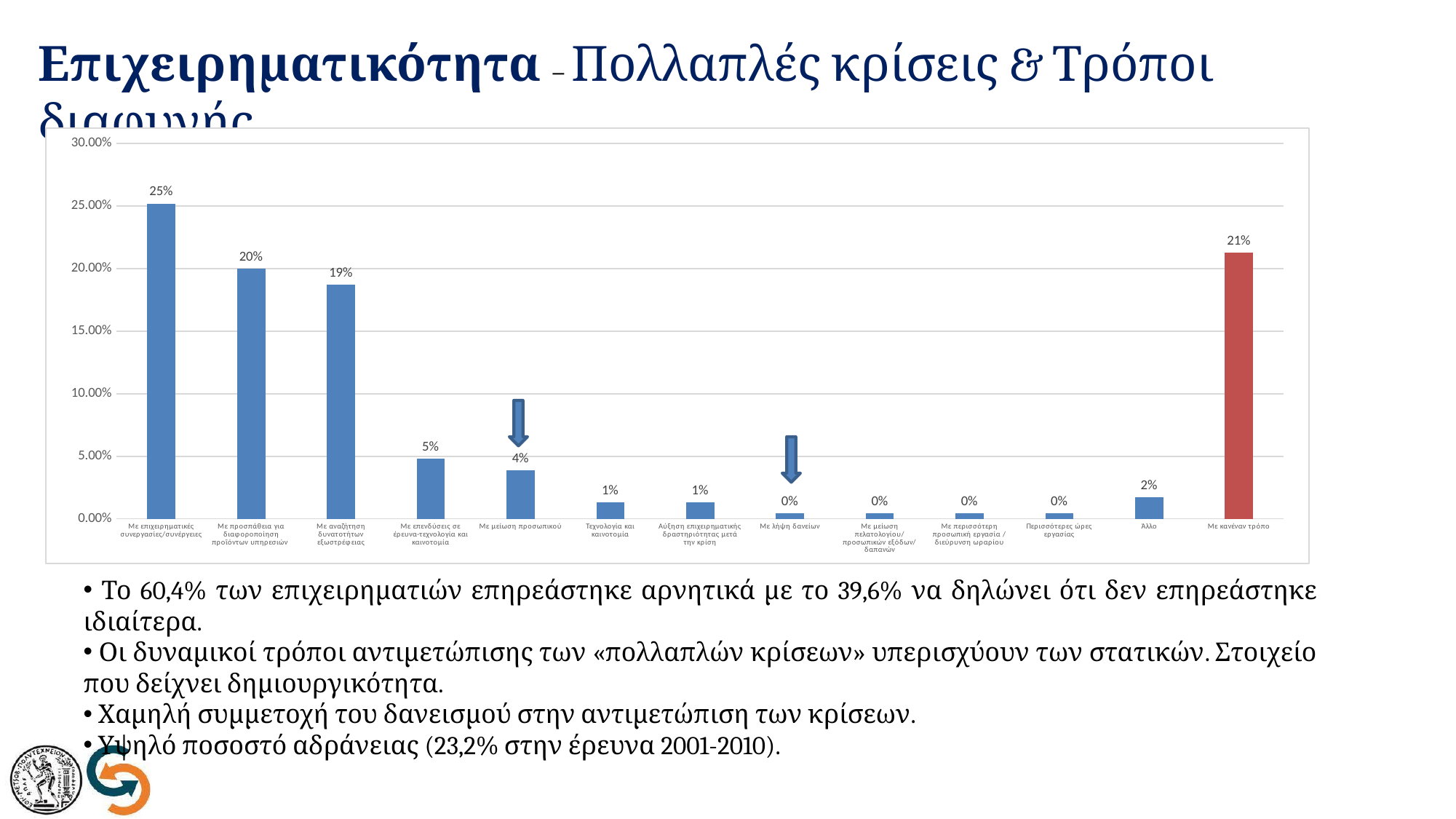
Is the value for "Με αναζήτηση δυνατοτήτων εξωστρέφειας" greater or less than 15.00%? greater What kind of chart is shown on the slide? Bar chart Which category is drawn with a red bar instead of a blue one? Με κανέναν τρόπο What is the value for "Με κανέναν τρόπο"? 21% Which category has the highest value in the chart? Με επιχειρηματικές συνεργασίες/συνέργειες Which is larger: the value for "Με προσπάθεια για διαφοροποίηση προϊόντων υπηρεσιών" or for "Με επενδύσεις σε έρευνα-τεχνολογία και καινοτομία"? Με προσπάθεια για διαφοροποίηση προϊόντων υπηρεσιών What is the value for "Με επιχειρηματικές συνεργασίες/συνέργειες"? 25% What is the value for "Με λήψη δανείων"? 0% What is the value for "Άλλο"? 2% What is the difference between the values for "Με επιχειρηματικές συνεργασίες/συνέργειες" and "Με κανέναν τρόπο"? 4% How many categories are plotted in the chart? 13 What is the value for "Με μείωση προσωπικού"? 4%